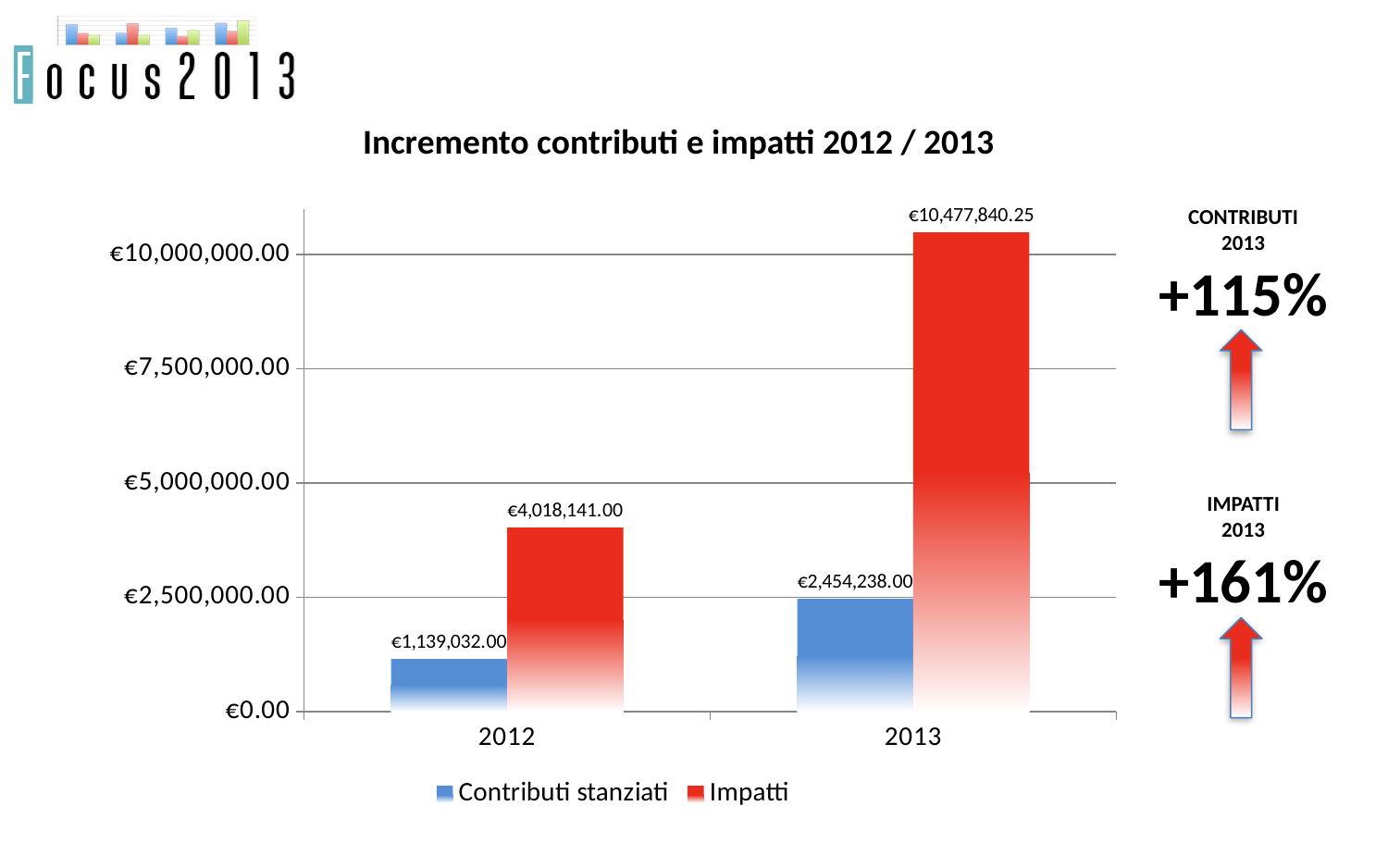
What is the value of Contributi stanziati for 2012? €1,139,032.00 What is the value of Contributi stanziati for 2013? €2,454,238.00 Which year has the highest Impatti value? 2013 What is the value of Impatti for 2013? €10,477,840.25 Which is larger: Impatti in 2012 or Contributi stanziati in 2013? Impatti in 2012 How many series does the legend list? 2 What kind of chart is shown on the slide? Bar chart Which bar in the chart has the lowest value? Contributi stanziati 2012 What is the value of Impatti for 2012? €4,018,141.00 What is the difference between Contributi stanziati in 2013 and in 2012? €1,315,206.00 What is the title of the chart? Incremento contributi e impatti 2012 / 2013 By how much did Impatti increase from 2012 to 2013? €6,459,699.25